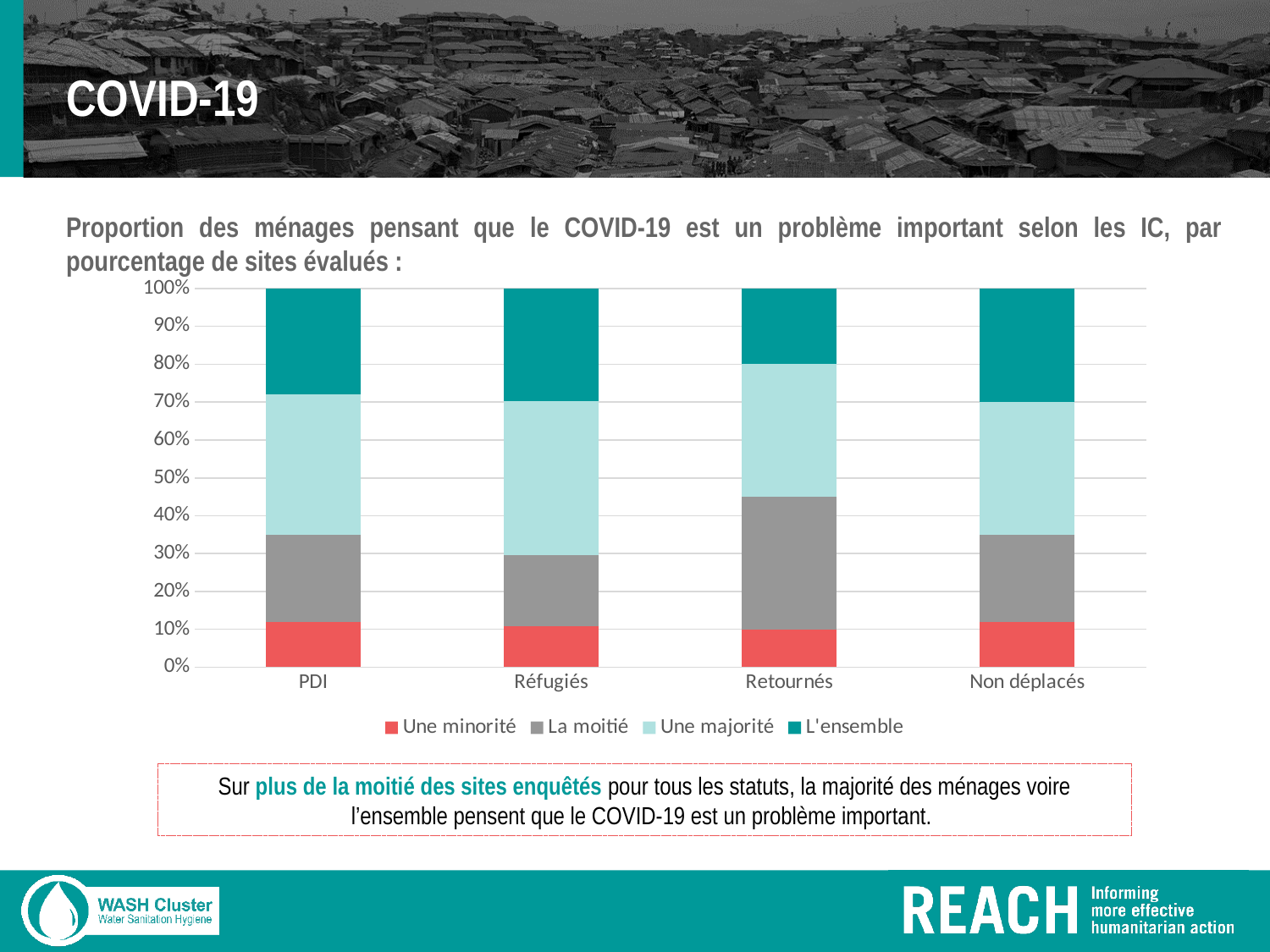
What is the total height of the stacked bar for PDI? 100% Which category has the smallest 'L'ensemble' segment? Retournés How many series does the chart legend list? 4 Is the 'L'ensemble' segment larger for Réfugiés or for Retournés? Réfugiés Which category has the largest 'La moitié' segment? Retournés Which legend entry is shown in red? Une minorité Is the 'La moitié' segment for Retournés greater or less than 30%? greater What kind of chart is shown on the slide? Stacked bar chart How many categories are shown along the x axis of the chart? 4 Is the 'Une minorité' segment for Réfugiés greater or less than 20%? less Is the 'L'ensemble' segment for Retournés greater or less than 30%? less Is the 'La moitié' segment larger for Retournés or for PDI? Retournés